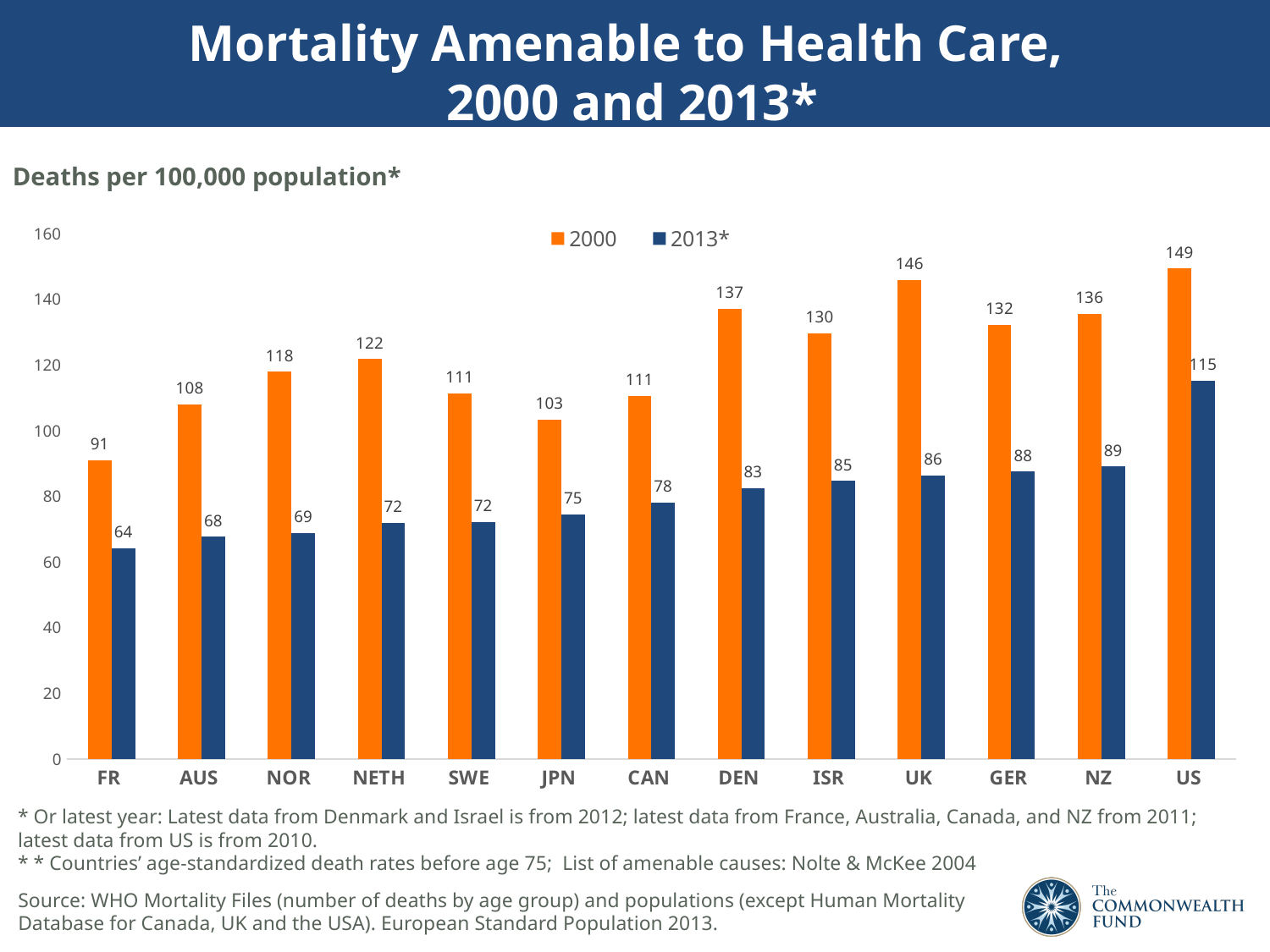
How many countries are shown on the x axis? 13 What is the difference between the 2013* values for the US and New Zealand (NZ)? 26 How many series does the legend list? 2 Which country had the highest value in 2013*? US Which is larger: the 2000 value for Denmark (DEN) or the 2000 value for Germany (GER)? Denmark (DEN) What kind of chart is shown on the slide? Bar chart What was the 2013* value for France (FR)? 64 What is the difference between the 2000 and 2013* values for the UK? 60 What was the 2013* value for Japan (JPN)? 75 Which country had the lowest value in 2000? FR What was the mortality amenable to health care for the US in 2000? 149 Which colour represents the 2000 series in the chart? Orange